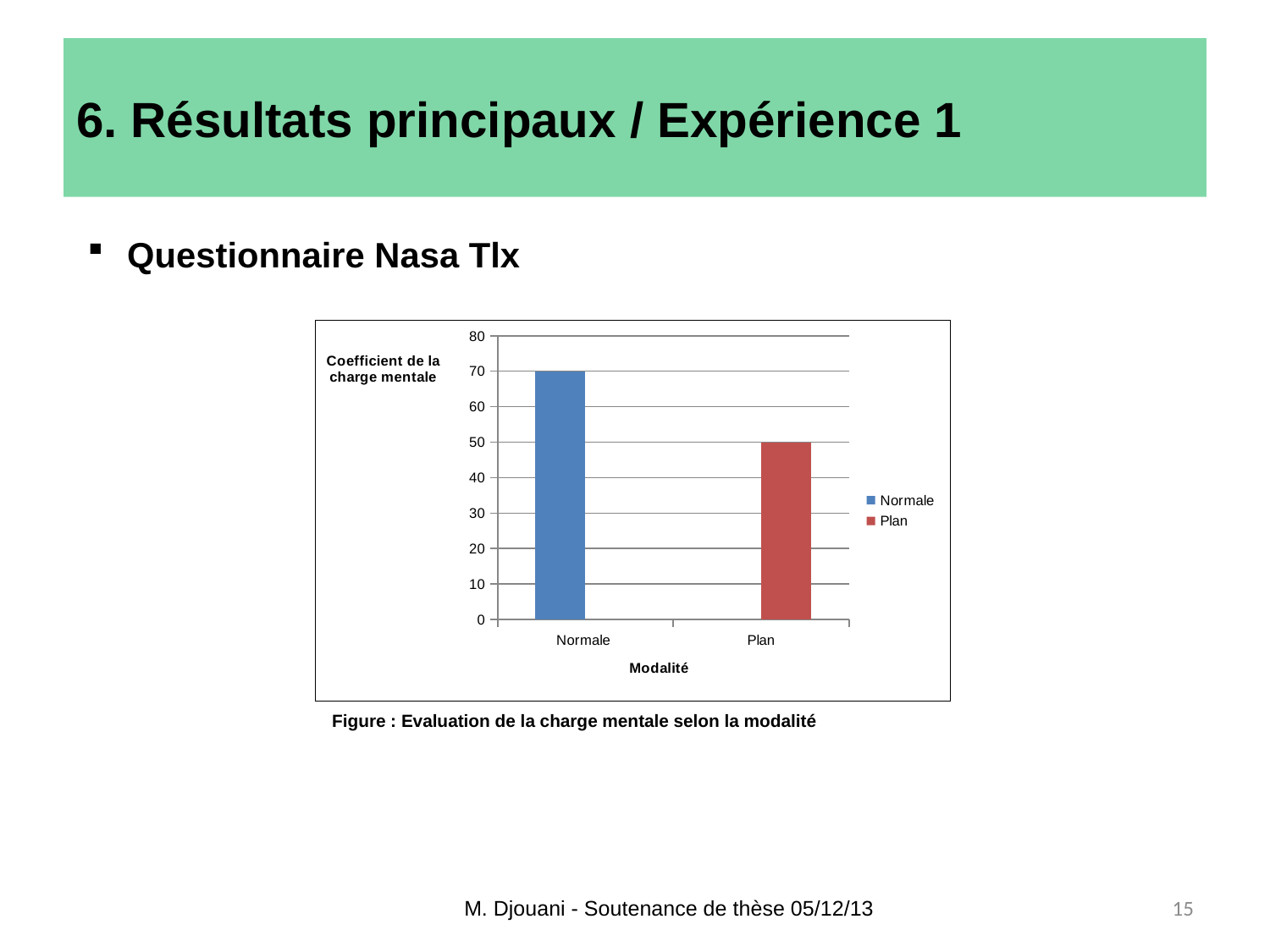
Is the value for Normale greater or less than 60? greater What kind of chart is shown on the slide? bar chart Is the value for Plan greater or less than 60? less What is the value for Plan? 50 What is the value for Normale? 70 Which modality has the lowest coefficient de la charge mentale? Plan Which modality has the highest coefficient de la charge mentale? Normale What is the label of the x axis? Modalité What is the difference between the values for Normale and Plan? 20 Which is larger, the value for Normale or the value for Plan? Normale How many series does the legend list? 2 How many categories are shown on the x axis? 2